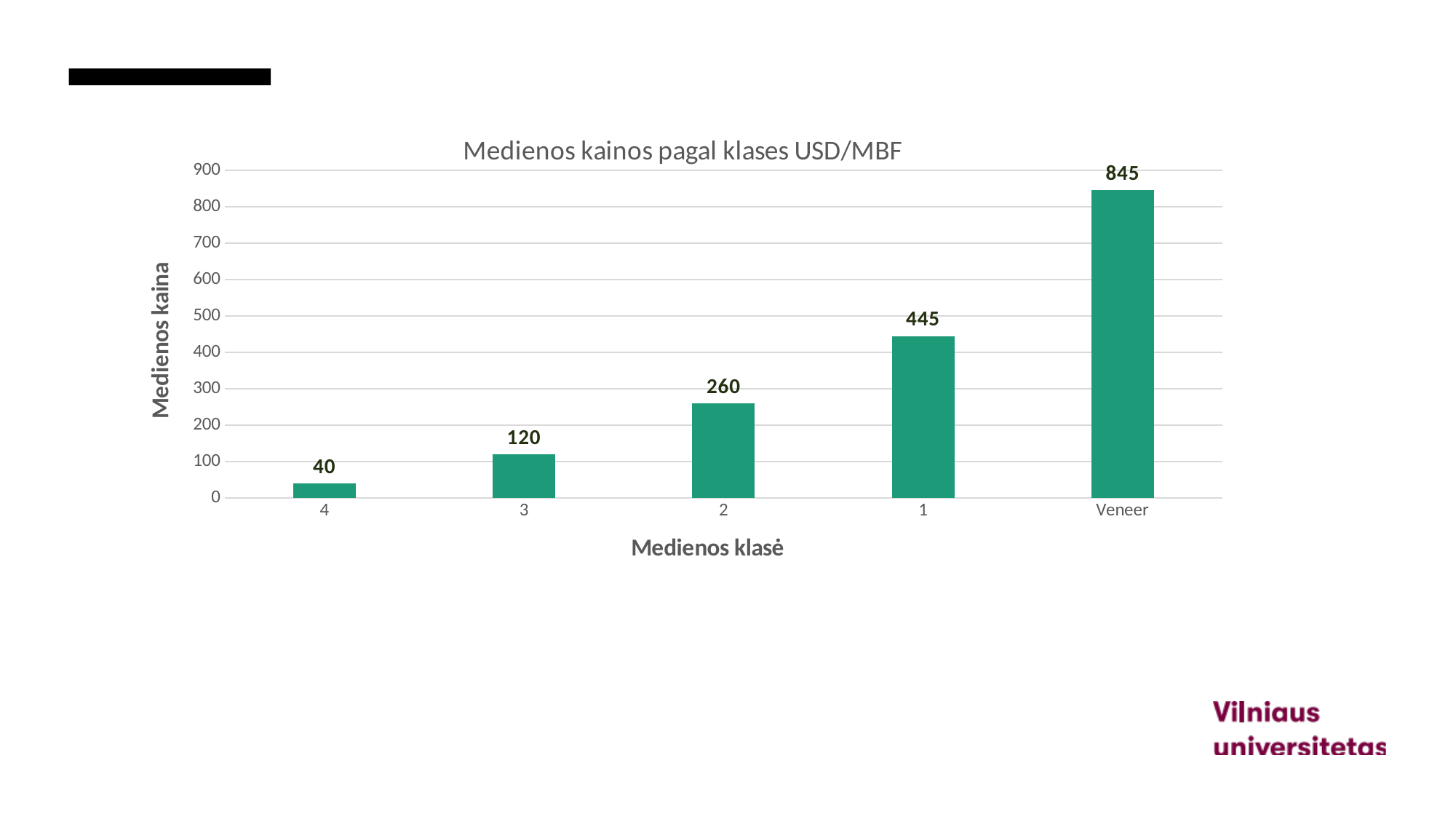
What is the value for class 4? 40 What is the value for class 3? 120 Which category has the highest value? Veneer What is the title of the chart? Medienos kainos pagal klases USD/MBF Which is larger, the value for class 2 or the value for class 3? 2 How many categories are shown on the x axis? 5 What is the value for Veneer? 845 Which category has the lowest value? 4 What kind of chart is this? bar chart What is the value for class 1? 445 What is the value for class 2? 260 What is the difference between the values for Veneer and class 1? 400